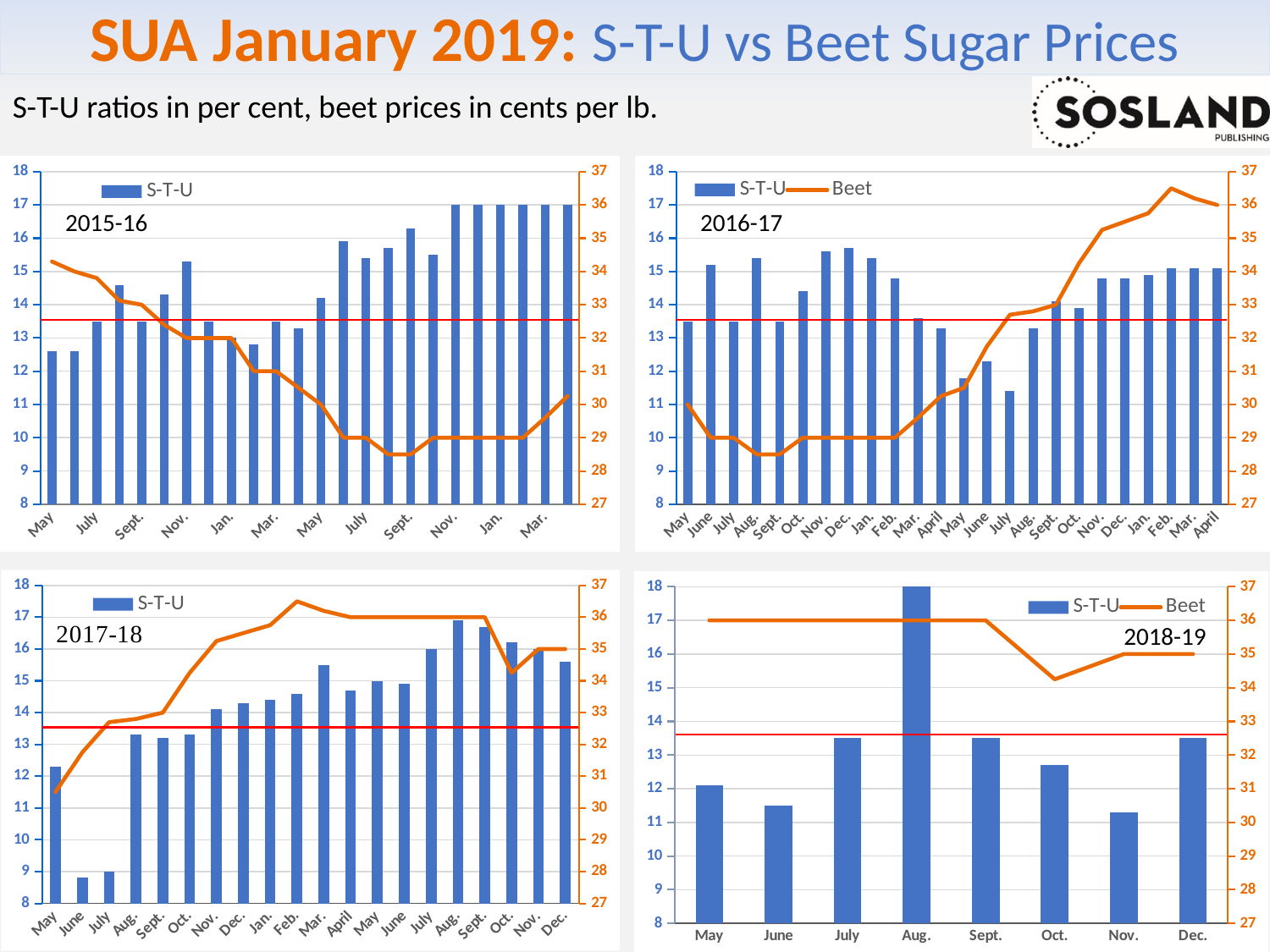
What kind of chart is used for the S-T-U series in each of the four charts? bar chart In the 2018-19 chart, how many series does the legend list? 2 In the 2018-19 chart, is the S-T-U value for June greater or less than 12? less In the 2015-16 chart, how many series does the legend list? 1 In the 2018-19 chart, how many months are shown on the x axis? 8 In the 2015-16 chart, does the Beet price line rise or fall overall from May to Mar.? fall In the 2018-19 chart, is the S-T-U value for Aug. greater or less than 17? greater In the 2018-19 chart, which month has the highest S-T-U bar? Aug. In the 2018-19 chart, what is the Beet price for May? 36 In the 2017-18 chart, is the S-T-U value for June greater or less than 10? less In the 2017-18 chart, does the Beet price line rise or fall overall from May to Dec.? rise In the 2016-17 chart, how many months are shown on the x axis? 24